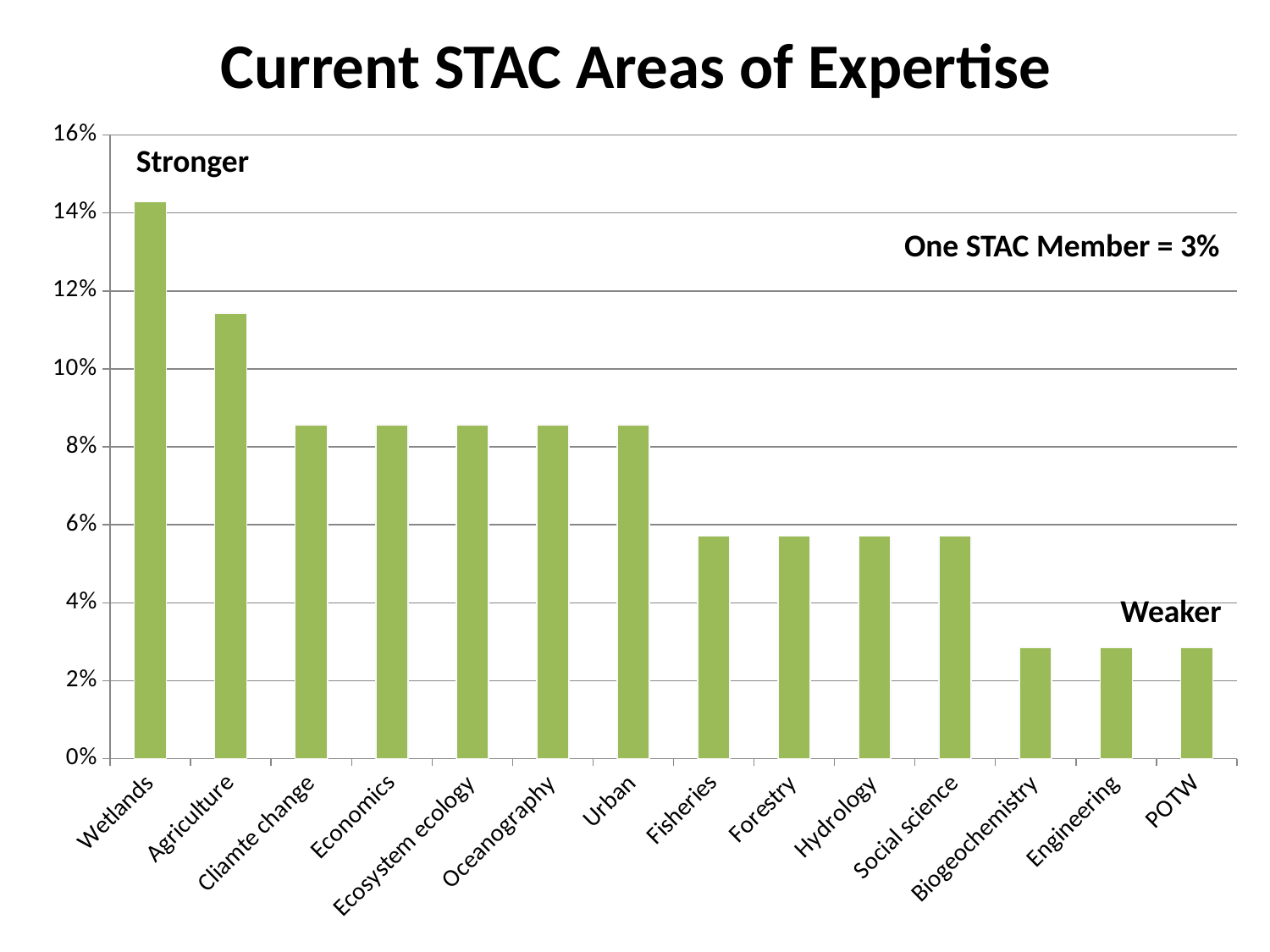
Which area of expertise has the highest value? Wetlands Do the values generally rise or fall moving from left to right along the x axis? fall What kind of chart is shown on the slide? bar chart Is the value for Agriculture greater or less than 12%? less Which is larger, the value for Hydrology or the value for Engineering? Hydrology Which is larger, the value for Agriculture or the value for Urban? Agriculture How many areas of expertise are plotted on the x axis? 14 Is the value for POTW greater or less than 4%? less Is the value for Wetlands greater or less than 14%? greater What is the title of the chart? Current STAC Areas of Expertise